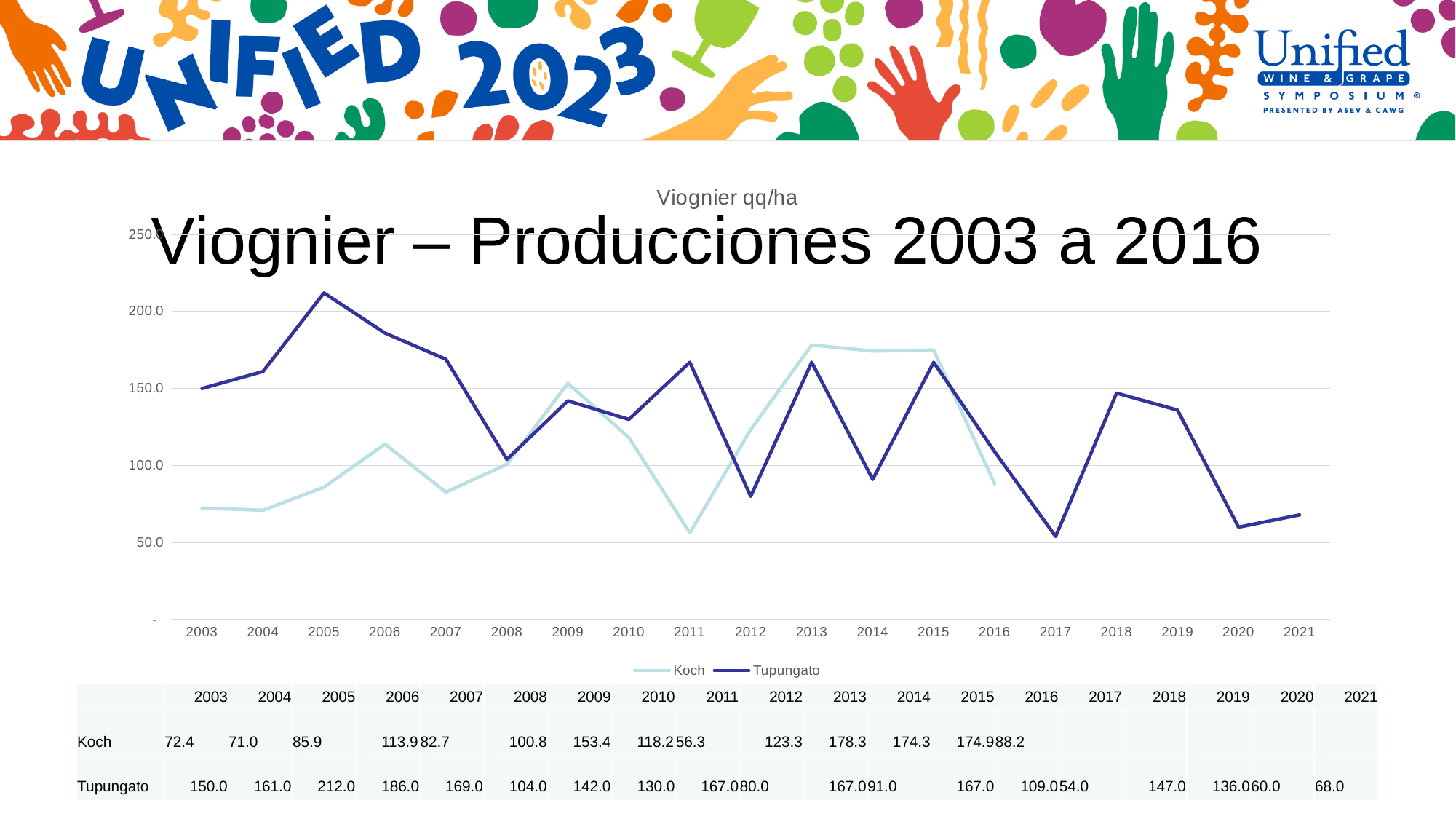
Is the Tupungato value for 2020 greater or less than 100.0? less What type of chart is shown on the slide? line chart How many series does the chart legend list? 2 What is the Tupungato value for 2017? 54.0 What is the Koch value for 2013? 178.3 What is the Tupungato value for 2005? 212.0 In which year does the Koch series reach its lowest value? 2011 How many years are shown on the x axis of the chart? 19 What is the title of the chart? Viognier qq/ha Which series has the larger value in 2014, Koch or Tupungato? Koch In which year does the Tupungato series reach its highest value? 2005 What is the difference between the Tupungato and Koch values in 2003? 77.6